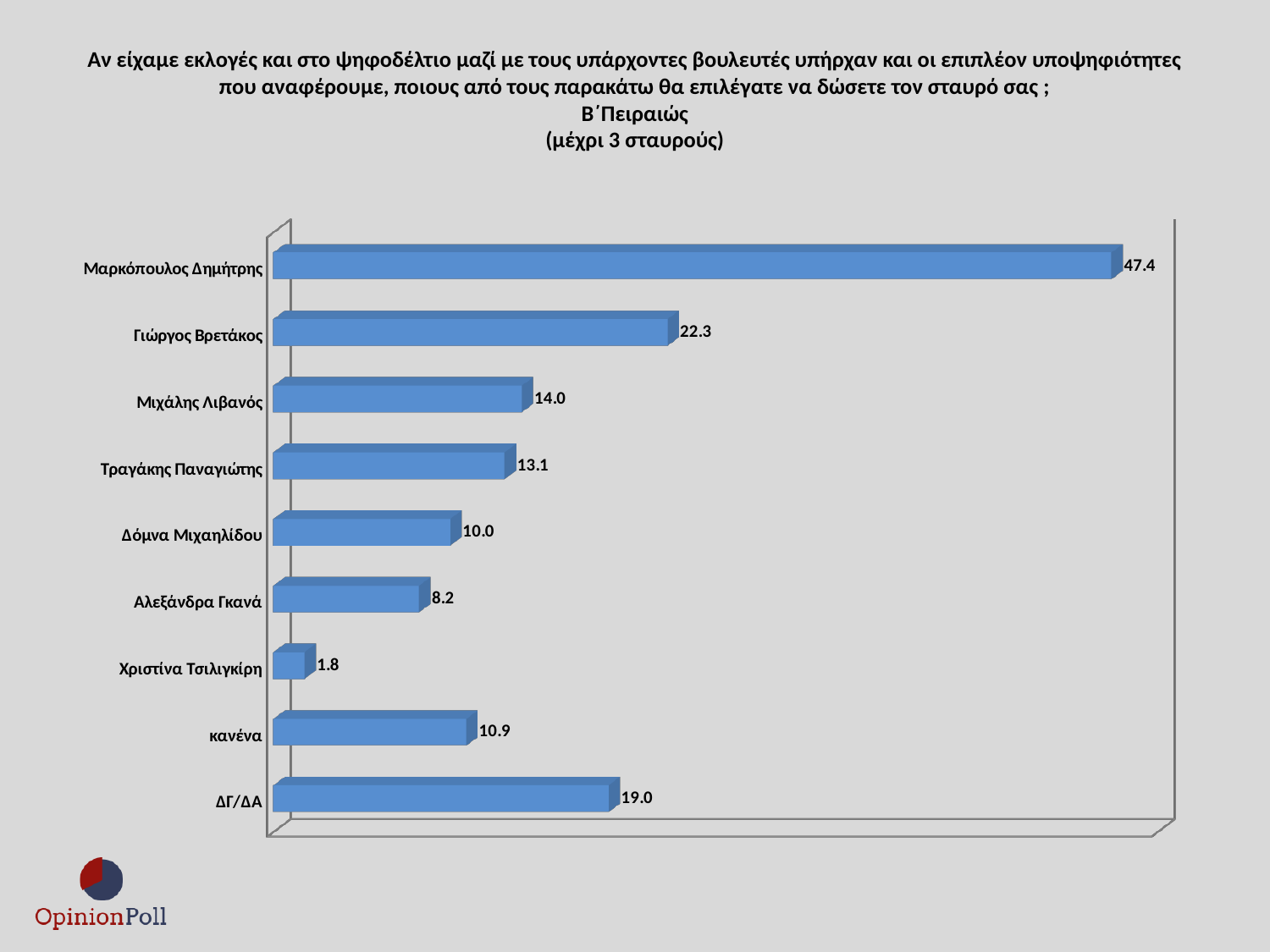
What is the value for Δόμνα Μιχαηλίδου? 10.0 What is the value for Χριστίνα Τσιλιγκίρη? 1.8 Which category has the highest value? Μαρκόπουλος Δημήτρης What is the value for Γιώργος Βρετάκος? 22.3 What is the difference between the values for Μιχάλης Λιβανός and Τραγάκης Παναγιώτης? 0.9 What is the difference between the values for Μαρκόπουλος Δημήτρης and Γιώργος Βρετάκος? 25.1 What is the value for Μαρκόπουλος Δημήτρης? 47.4 What kind of chart is shown on the slide? Bar chart What is the value for ΔΓ/ΔΑ? 19.0 Which category has the lowest value? Χριστίνα Τσιλιγκίρη Which is larger, the value for κανένα or the value for Αλεξάνδρα Γκανά? κανένα How many categories are shown in the chart? 9